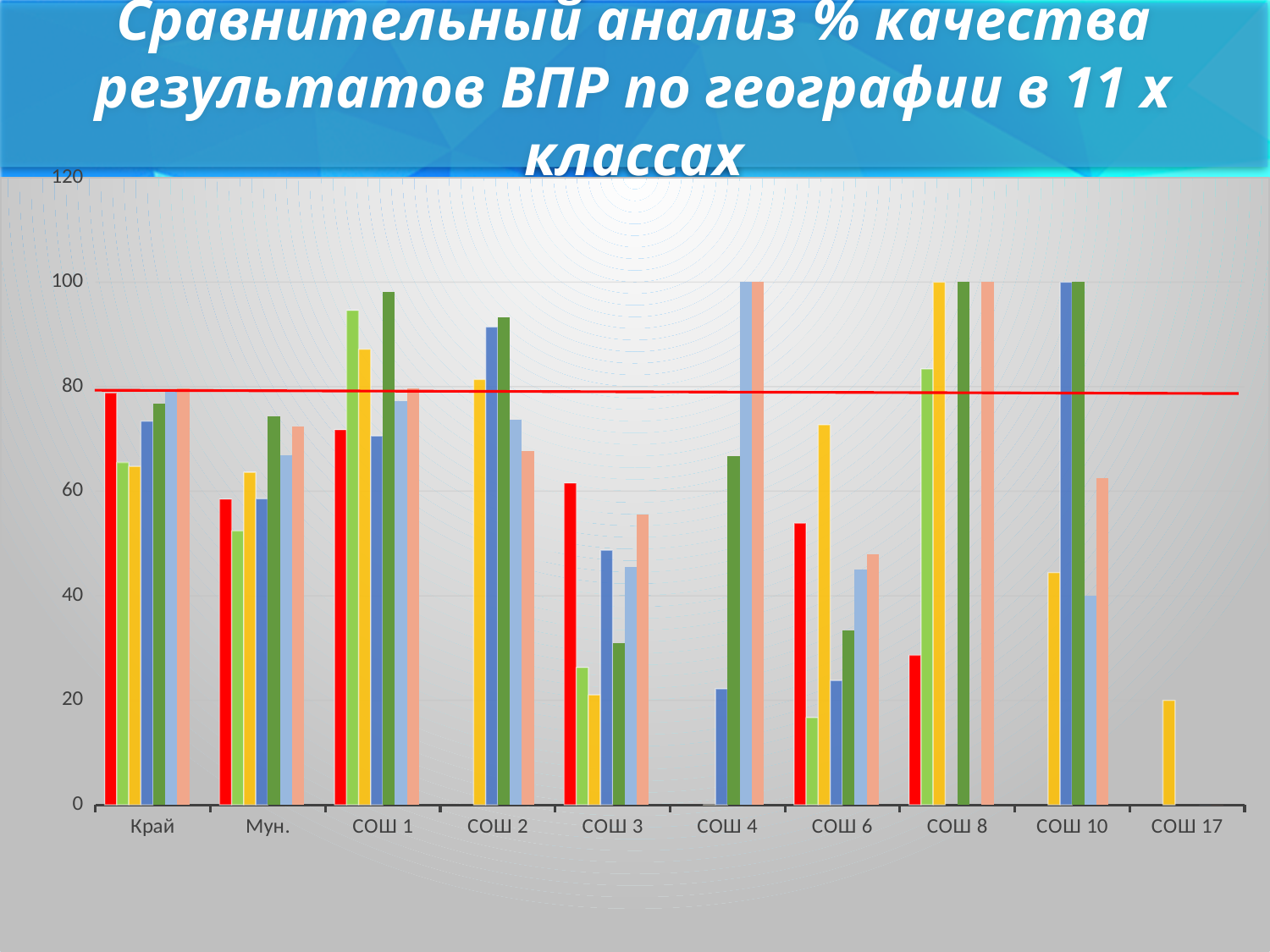
What is the title of the chart on the slide? Сравнительный анализ % качества результатов ВПР по географии в 11 х классах Which is larger: the red bar for Край or the red bar for СОШ 8? Край Which category has the tallest red bar? Край How many categories are shown along the x axis of the chart? 10 What value does the dark green bar for СОШ 10 reach? 100 What kind of chart is shown on the slide? bar chart What value does the light blue bar for СОШ 4 reach? 100 Is the value of the red bar for Край greater or less than 60? greater Is the value of the yellow bar for СОШ 17 greater or less than 40? less Is the value of the red bar for СОШ 6 greater or less than 60? less How many bars are plotted for the category СОШ 17? 1